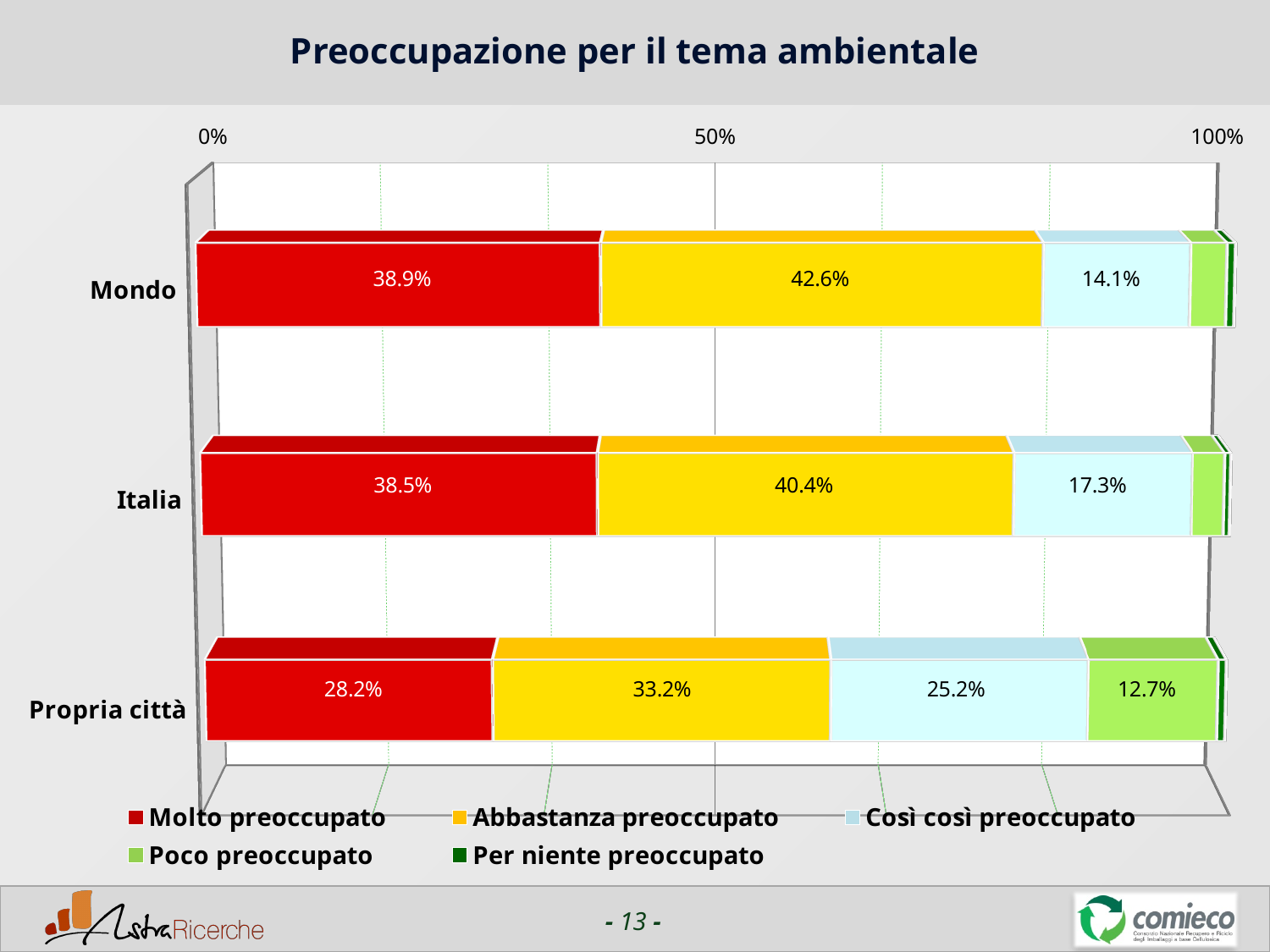
What is the value for "Poco preoccupato" for Propria città? 12.7% What is the difference between the "Così così preoccupato" values for Propria città and Mondo? 11.1% Which category has the highest value for "Molto preoccupato"? Mondo How many series does the legend list? 5 Which is larger: the "Abbastanza preoccupato" value for Mondo or for Italia? Mondo How many categories are shown on the chart? 3 What is the value for "Molto preoccupato" for Mondo? 38.9% What is the value for "Abbastanza preoccupato" for Italia? 40.4% What is the title of the chart? Preoccupazione per il tema ambientale What is the value for "Così così preoccupato" for Propria città? 25.2% What kind of chart is shown on the slide? Stacked bar chart Which category has the lowest value for "Abbastanza preoccupato"? Propria città